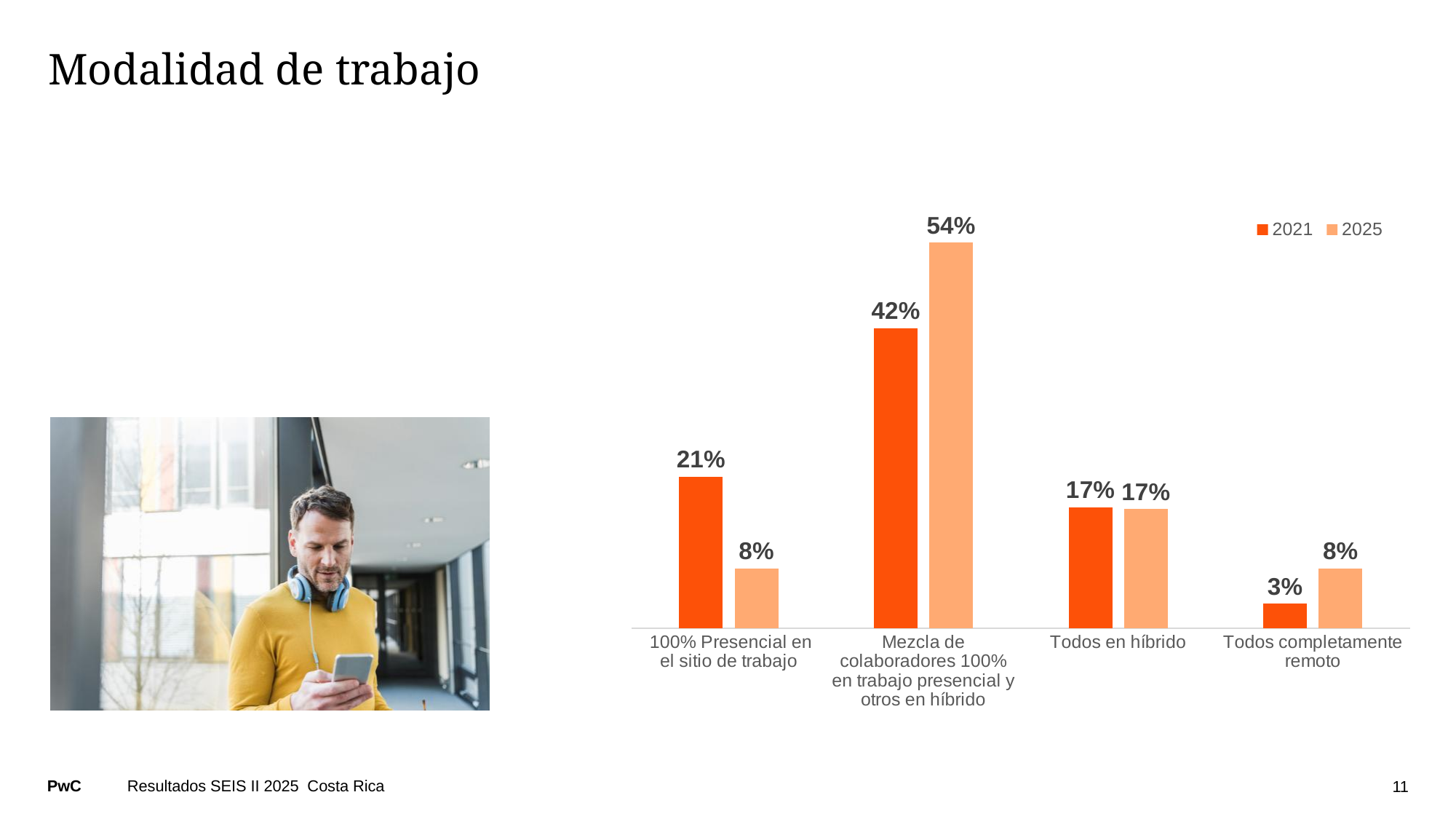
How many categories are shown on the x axis? 4 How many series does the legend list? 2 Which category has the lowest 2021 value? Todos completamente remoto What is the 2025 value for "Todos completamente remoto"? 8% Which is larger for "Todos completamente remoto": the 2021 value or the 2025 value? 2025 Which category has the highest 2025 value? Mezcla de colaboradores 100% en trabajo presencial y otros en híbrido What is the difference between the 2021 and 2025 values for "100% Presencial en el sitio de trabajo"? 13% What is the difference between the 2025 and 2021 values for "Mezcla de colaboradores 100% en trabajo presencial y otros en híbrido"? 12% What is the 2025 value for "Mezcla de colaboradores 100% en trabajo presencial y otros en híbrido"? 54% What kind of chart is shown on the slide? Bar chart What is the 2021 value for "100% Presencial en el sitio de trabajo"? 21% Which series is shown in the lighter orange colour? 2025